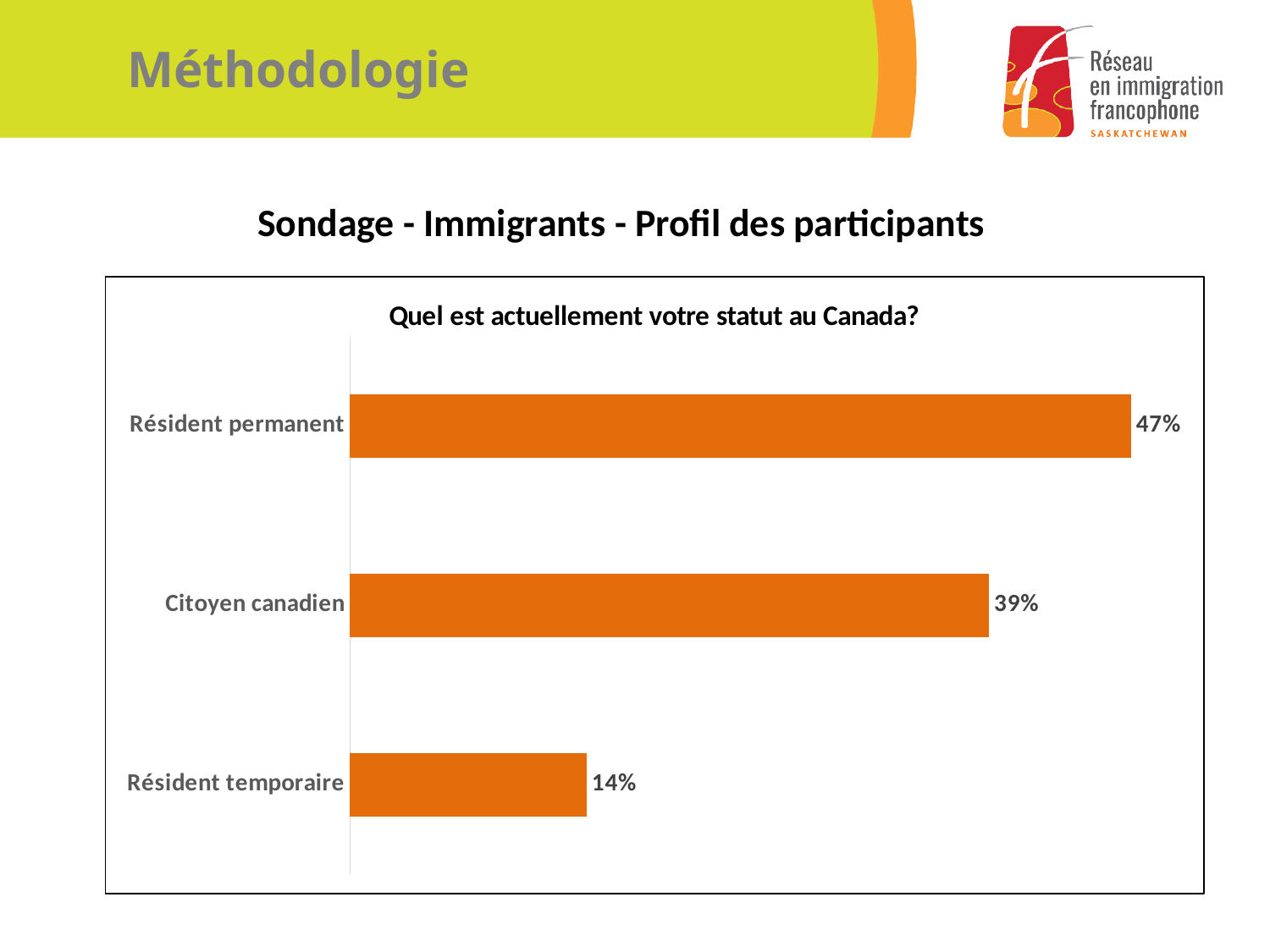
Which category has the highest value? Résident permanent What is the difference between the values for Résident permanent and Citoyen canadien? 8% How many categories are shown in the chart? 3 What is the value for Citoyen canadien? 39% What is the title of the chart? Quel est actuellement votre statut au Canada? Which category has the lowest value? Résident temporaire What is the difference between the values for Citoyen canadien and Résident temporaire? 25% Which is larger, the value for Citoyen canadien or the value for Résident temporaire? Citoyen canadien What is the value for Résident permanent? 47% What kind of chart is shown on the slide? Bar chart What colour are the bars in the chart? Orange What is the value for Résident temporaire? 14%